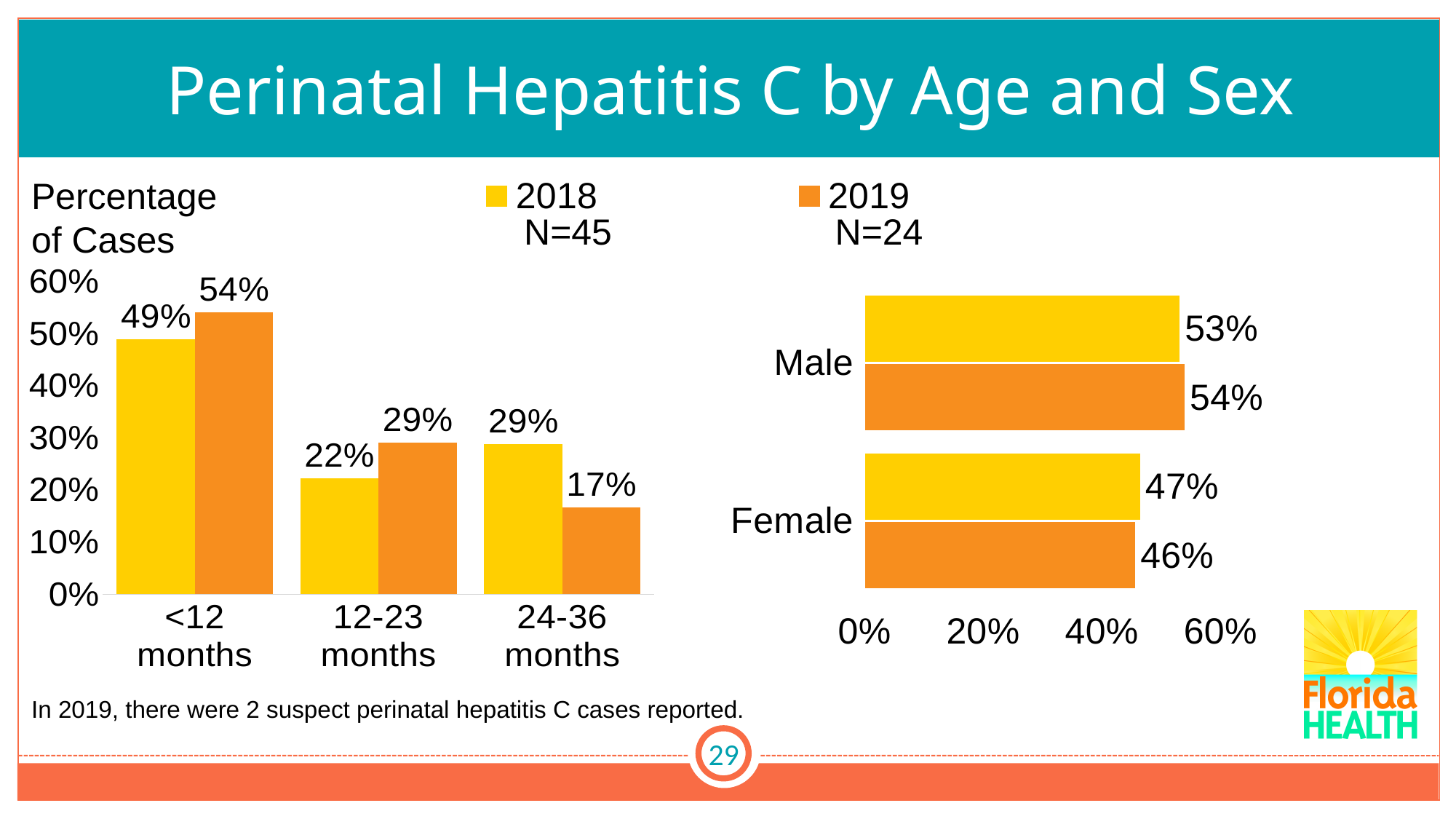
How many age groups are shown in the age chart on the left? 3 In the age chart on the left, what is the 2019 value for 24-36 months? 17% In the age chart on the left, what is the difference between the 2019 and 2018 values for 12-23 months? 7% In the age chart on the left, which age group has the lowest 2018 value? 12-23 months In the sex chart on the right, what is the difference between the Male and Female values for 2019? 8% In the sex chart on the right, what is the 2018 value for Male? 53% How many series does the legend list? 2 In the age chart on the left, which age group has the highest 2019 value? <12 months In the sex chart on the right, what is the 2019 value for Female? 46% In the age chart on the left, which is larger for 24-36 months, the 2018 value or the 2019 value? 2018 What type of chart is the sex chart on the right? Bar chart In the age chart on the left, what is the 2018 value for <12 months? 49%